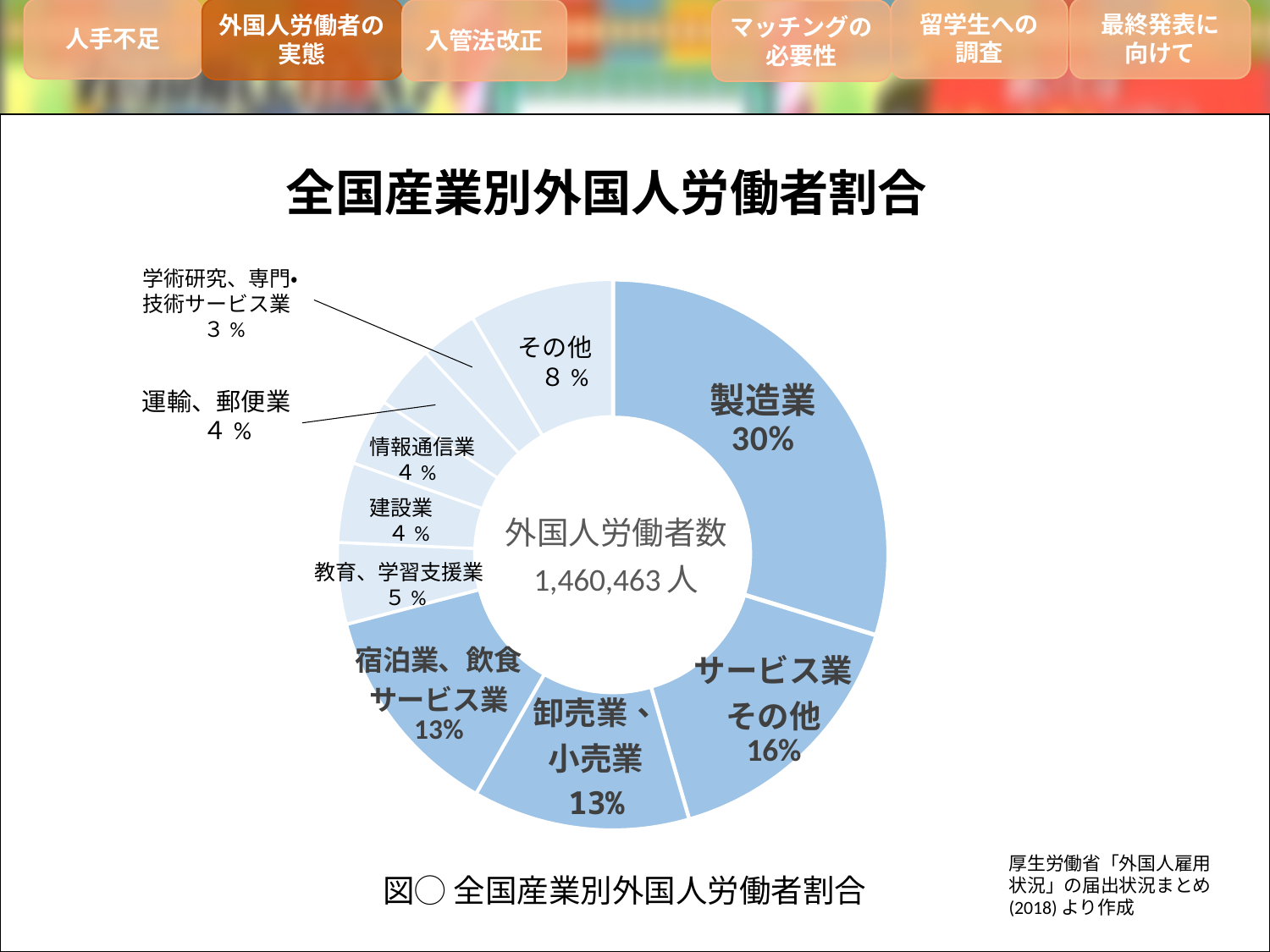
What is the difference in percentage points between 製造業 and サービス業その他? 14 Which is larger, the share for 卸売業、小売業 or the share for 教育、学習支援業? 卸売業、小売業 Which category has the largest share of the pie? 製造業 What is the value shown for その他? 8% What is the value shown for 教育、学習支援業? 5% What total number of foreign workers is printed in the centre of the chart? 1,460,463 人 Which category has the smallest share of the pie? 学術研究、専門・技術サービス業 How many categories are shown in the chart? 10 What kind of chart is shown on the slide? Pie chart (donut) What share of the pie does サービス業その他 hold? 16% What share of the pie does 製造業 hold? 30% What is the value shown for 学術研究、専門・技術サービス業? 3%